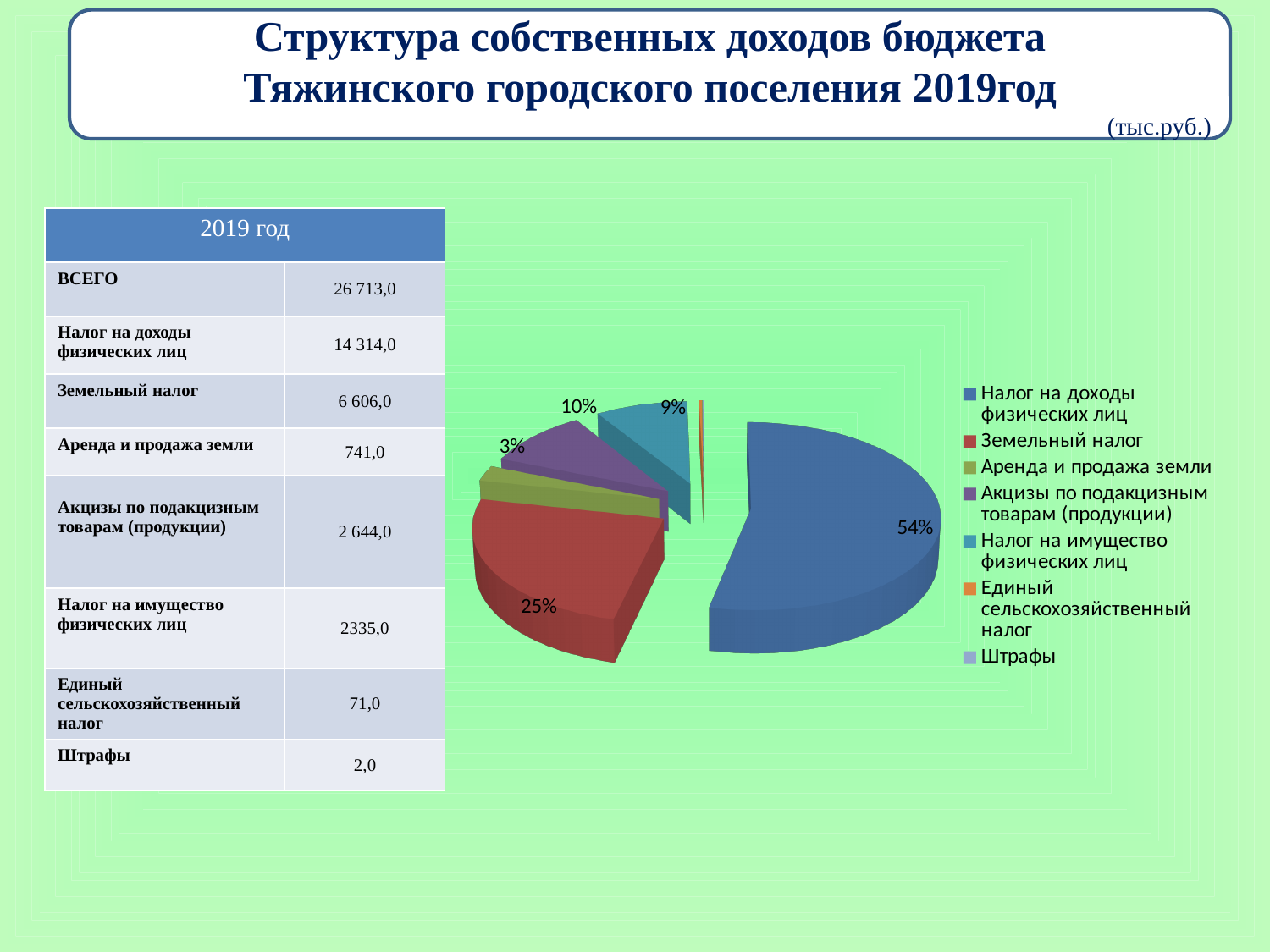
What share of the pie does Акцизы по подакцизным товарам (продукции) have? 10% What colour is the slice for Земельный налог? red What share of the pie does Аренда и продажа земли have? 3% What share of the pie does Земельный налог have? 25% Which category has the largest slice of the pie? Налог на доходы физических лиц What is the combined share of Земельный налог and Налог на имущество физических лиц? 34% How many entries does the legend list? 7 What is the difference in percentage points between the Налог на доходы физических лиц slice and the Земельный налог slice? 29 What kind of chart is shown on the slide? pie chart Which slice is larger: Акцизы по подакцизным товарам (продукции) or Аренда и продажа земли? Акцизы по подакцизным товарам (продукции)